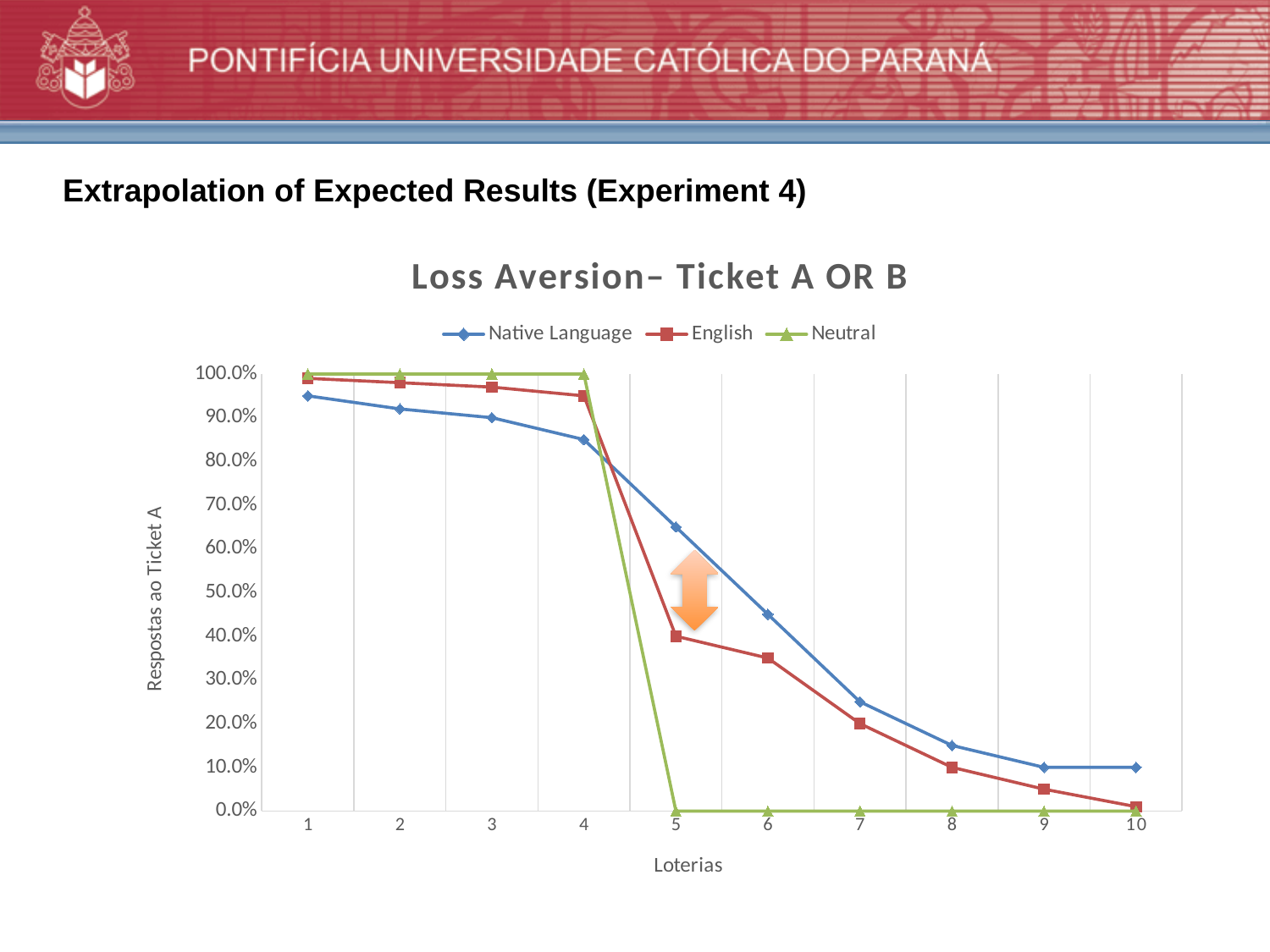
How many lottery (Loterias) points are plotted along the x axis? 10 At lottery 3, which series has the larger value, Neutral or Native Language? Neutral What is the title of the chart? Loss Aversion– Ticket A OR B Is the value for English at lottery 6 greater or less than 40.0%? less What kind of chart is shown on the slide? line chart At lottery 5, which series has the larger value, Native Language or English? Native Language Is the value for Native Language at lottery 1 greater or less than 90.0%? greater Is the value for Native Language at lottery 5 greater or less than 60.0%? greater What is the value of the Neutral series at lottery 3? 100.0% Do the values of the Native Language series rise or fall from lottery 1 to lottery 10? fall How many series does the legend list? 3 What is the value of the Neutral series at lottery 7? 0.0%